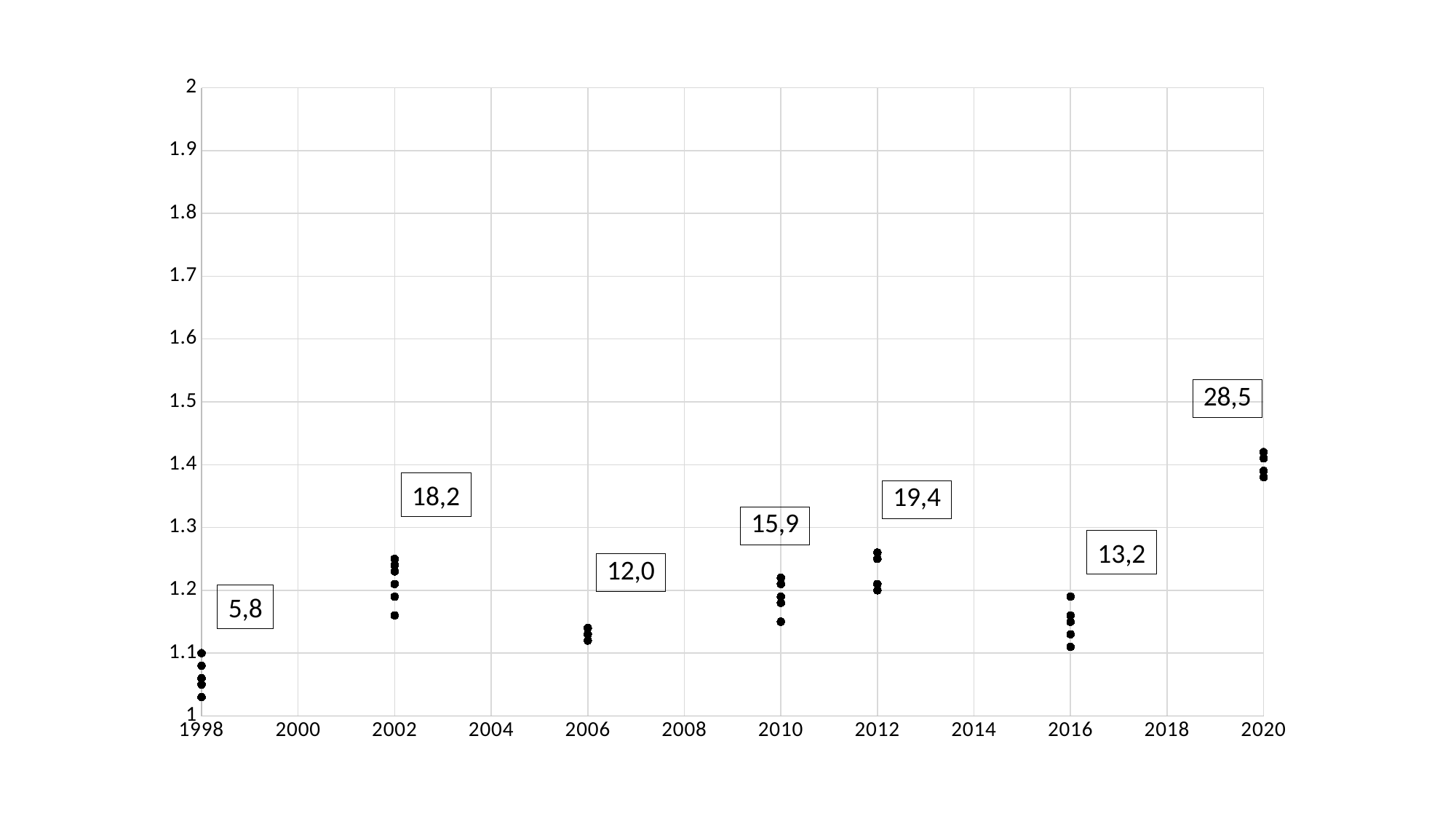
What is the highest value shown on the vertical axis? 2 Are the plotted values for 1998 greater or less than 1.2? less What kind of chart is shown on the slide? scatter chart Are the plotted values for 2020 greater or less than 1.3? greater What value is shown in the label box above the 2020 points? 28,5 Are the plotted points for 2020 higher or lower than those for 2016? higher Which year has the lowest plotted points? 1998 Are the plotted values for 2006 greater or less than 1.2? less How many years have data points plotted on the chart? 7 What value is shown in the label box next to the 1998 points? 5,8 Which year has the highest plotted points? 2020